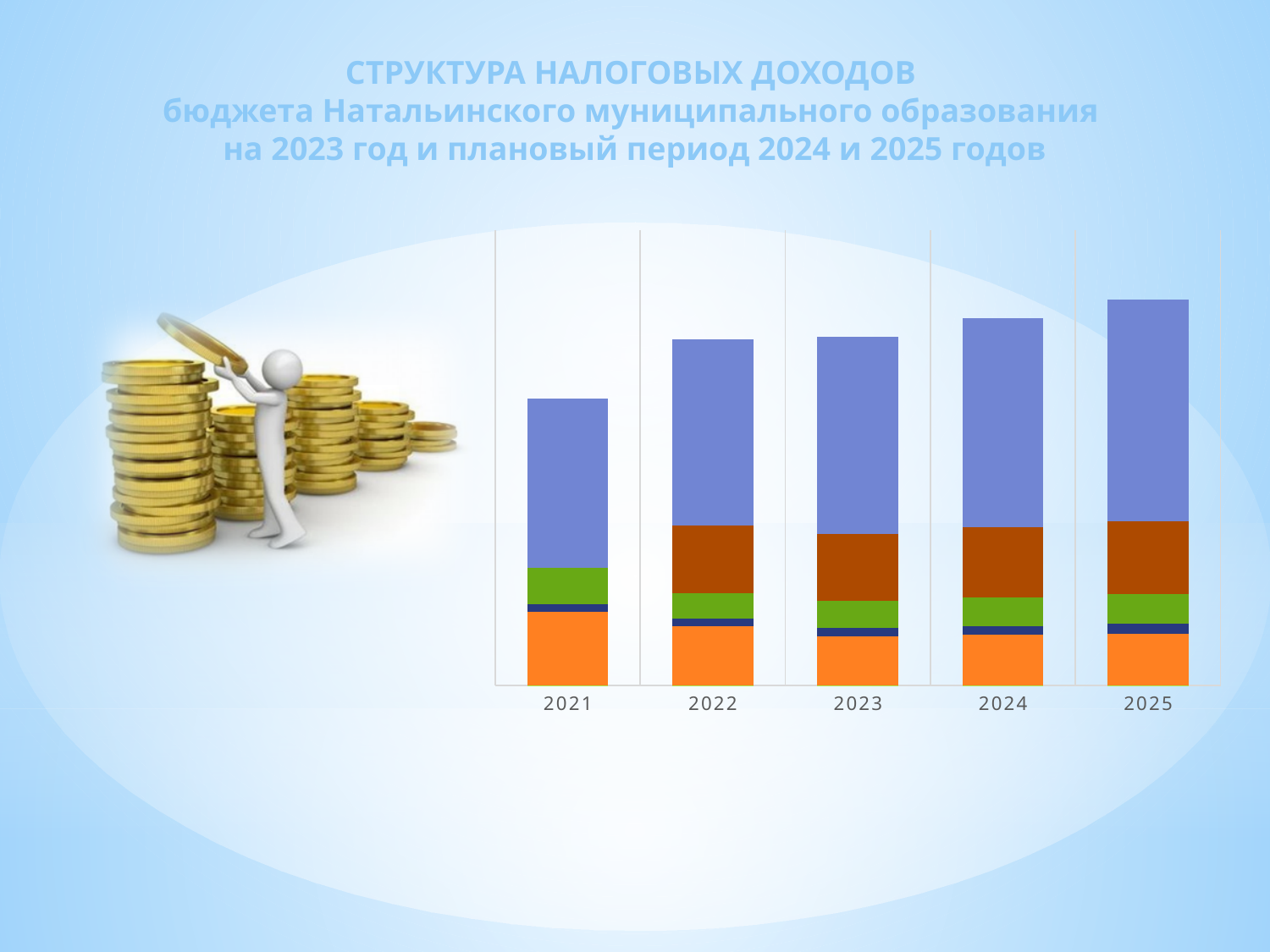
Which is the first year shown on the x axis? 2021 Is the total bar for 2025 taller or shorter than the bar for 2021? Taller What kind of chart is shown on the slide? Stacked bar chart How many years are shown on the x axis of the chart? 5 Which year has the tallest bar in the chart? 2025 Do the total bar heights generally rise or fall from 2021 to 2025? Rise Which year has the shortest bar in the chart? 2021 Which colour segment is the largest in every bar of the chart? Blue (light purple-blue) Which is the last year shown on the x axis? 2025 Which bar is taller, 2024 or 2023? 2024 What is the first line of the slide title? СТРУКТУРА НАЛОГОВЫХ ДОХОДОВ